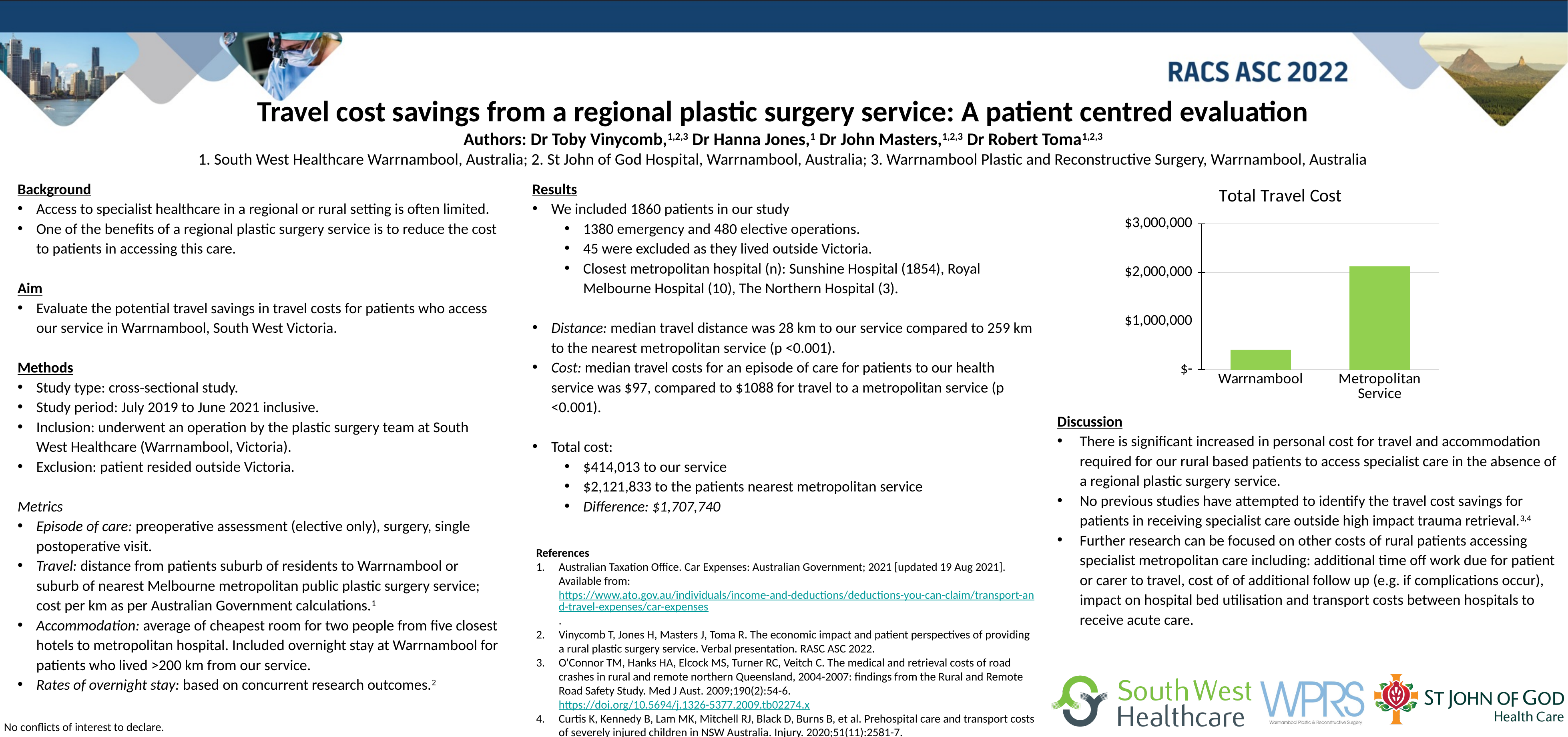
What is the highest value labelled on the vertical axis of the chart? $3,000,000 What kind of chart is shown on the slide? bar chart Which category has the lowest total travel cost in the chart? Warrnambool Do the values rise or fall moving from Warrnambool to Metropolitan Service along the x axis? rise Which category has the highest total travel cost in the chart? Metropolitan Service Is the value for Metropolitan Service greater or less than $1,000,000? greater Is the value for Metropolitan Service greater or less than $3,000,000? less Which is larger in the chart, the value for Warrnambool or the value for Metropolitan Service? Metropolitan Service How many categories are plotted in the Total Travel Cost chart? 2 What is the title of the chart? Total Travel Cost Is the value for Warrnambool greater or less than $1,000,000? less